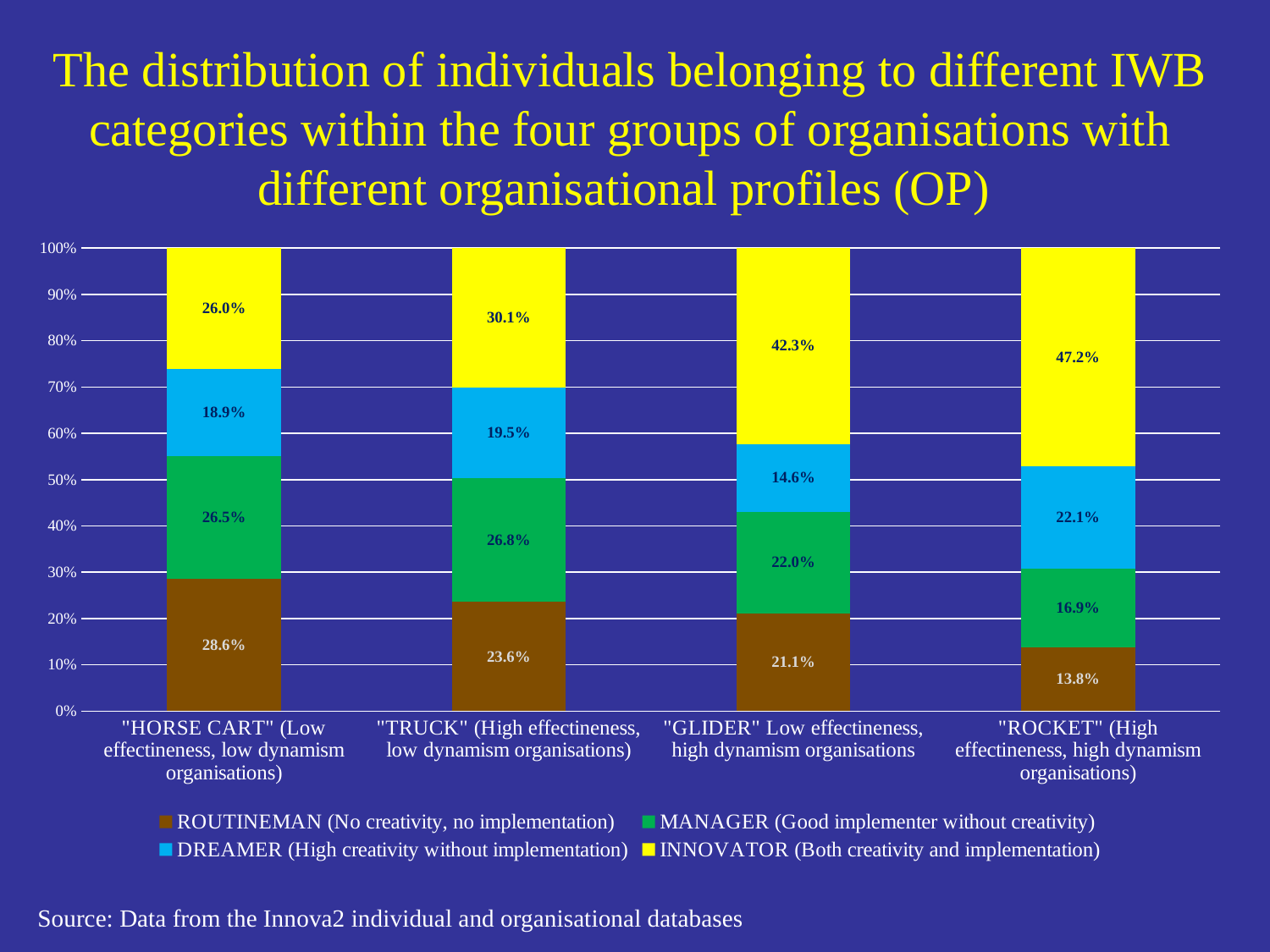
How many series does the legend list? 4 What is the ROUTINEMAN share for the "HORSE CART" group? 28.6% Which colour represents the DREAMER category in the legend? Light blue What is the difference between the INNOVATOR share in the "ROCKET" group and in the "HORSE CART" group? 21.2 percentage points Which group of organisations has the highest INNOVATOR share? "ROCKET" (High effectiveness, high dynamism organisations) Does the INNOVATOR share rise or fall moving from "HORSE CART" to "ROCKET" along the x axis? Rise What is the DREAMER share for the "GLIDER" group? 14.6% What kind of chart is shown on the slide? Stacked bar chart Which group of organisations has the lowest ROUTINEMAN share? "ROCKET" (High effectiveness, high dynamism organisations) What is the INNOVATOR share for the "ROCKET" group? 47.2% Which is larger: the MANAGER share in the "TRUCK" group or in the "GLIDER" group? "TRUCK" (26.8%) How many groups of organisations are shown on the x axis? 4